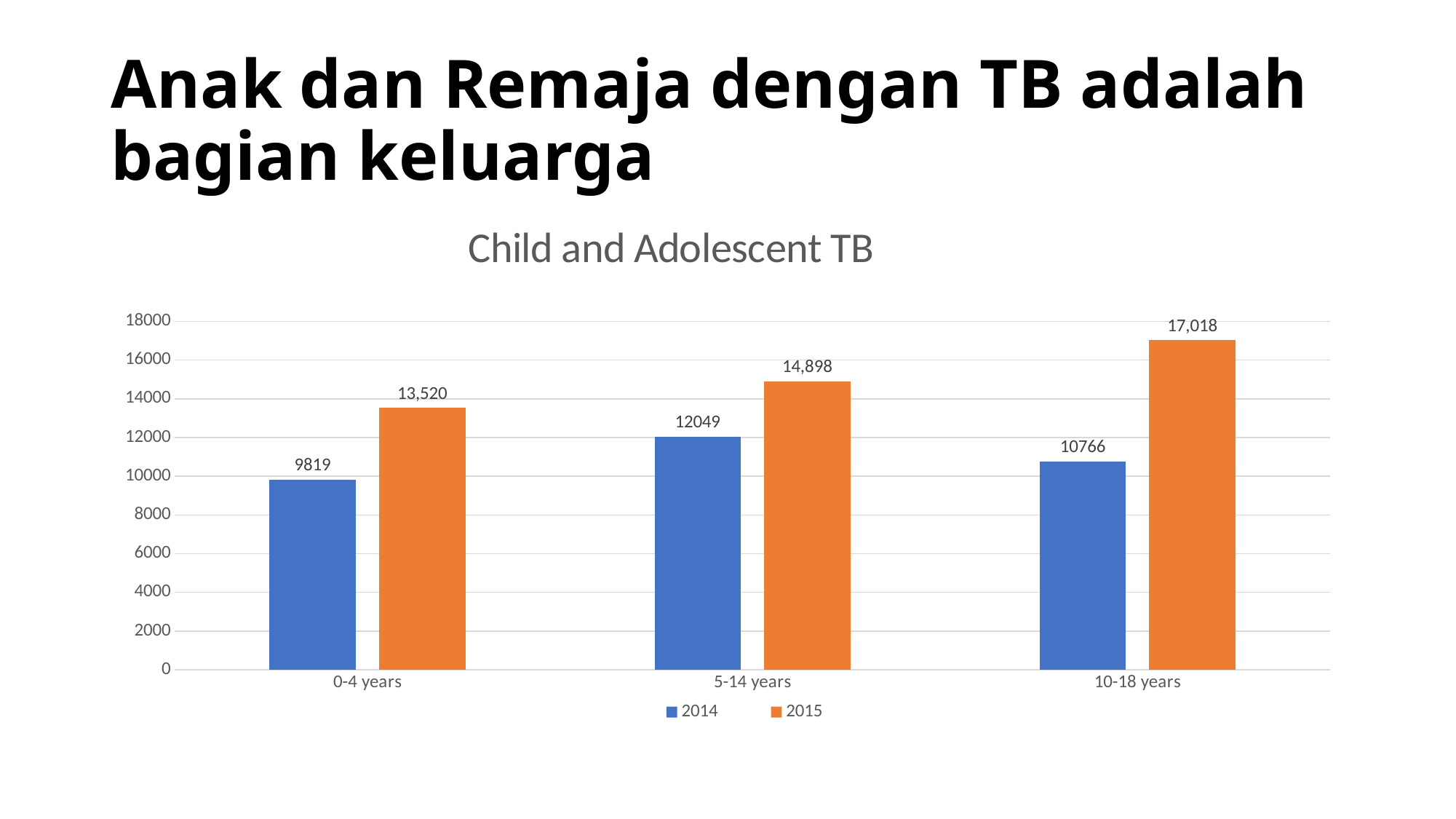
What is the value for 2015 in the 5-14 years category? 14,898 Is the value for 2014 in the 10-18 years category greater or less than 12000? less How many age categories are shown on the x axis? 3 How many series does the legend list? 2 What is the value for 2014 in the 0-4 years category? 9819 What is the value for 2015 in the 10-18 years category? 17,018 Which age category has the highest value for 2015? 10-18 years Which is larger for 5-14 years, the 2014 value or the 2015 value? 2015 What kind of chart is shown on the slide? bar chart What is the difference between the 2015 and 2014 values for 0-4 years? 3,701 What is the title of the chart? Child and Adolescent TB Which age category has the lowest value for 2014? 0-4 years